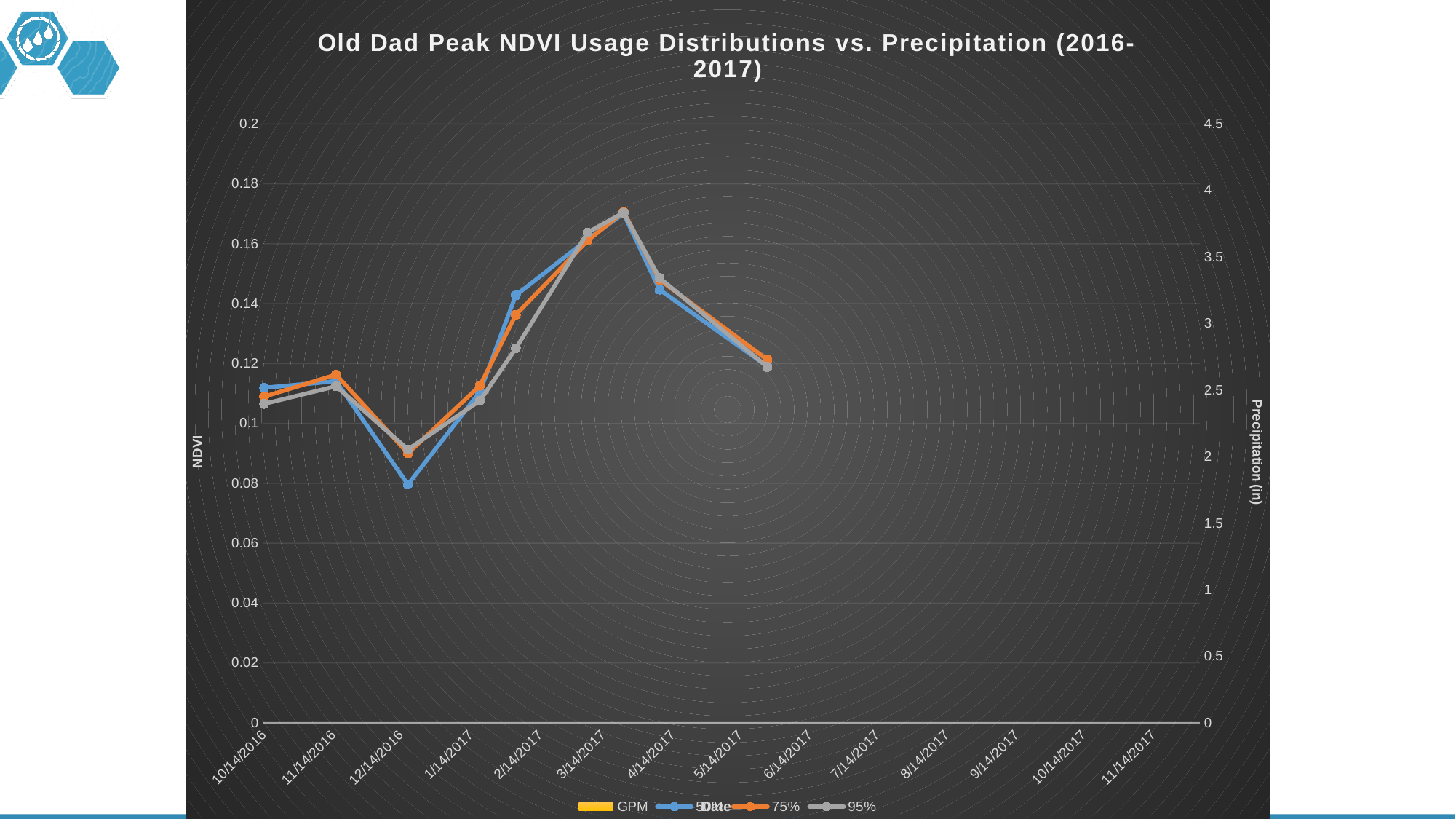
Is the value of the 50% series at 10/14/2016 greater or less than 0.1? greater What is the title of the chart? Old Dad Peak NDVI Usage Distributions vs. Precipitation (2016-2017) At 12/14/2016, which series has the larger value, 50% or 75%? 75% How many series does the legend list? 4 Is the value of the 95% series at 12/14/2016 greater or less than 0.1? less Is the value of the 95% series at 2/14/2017 greater or less than 0.14? less What kind of chart is shown on the slide? line chart At 2/14/2017, which series has the larger value, 50% or 95%? 50% Do the values of the 50% series rise or fall between 12/14/2016 and 3/14/2017? rise What is the title of the right-hand vertical axis? Precipitation (in)